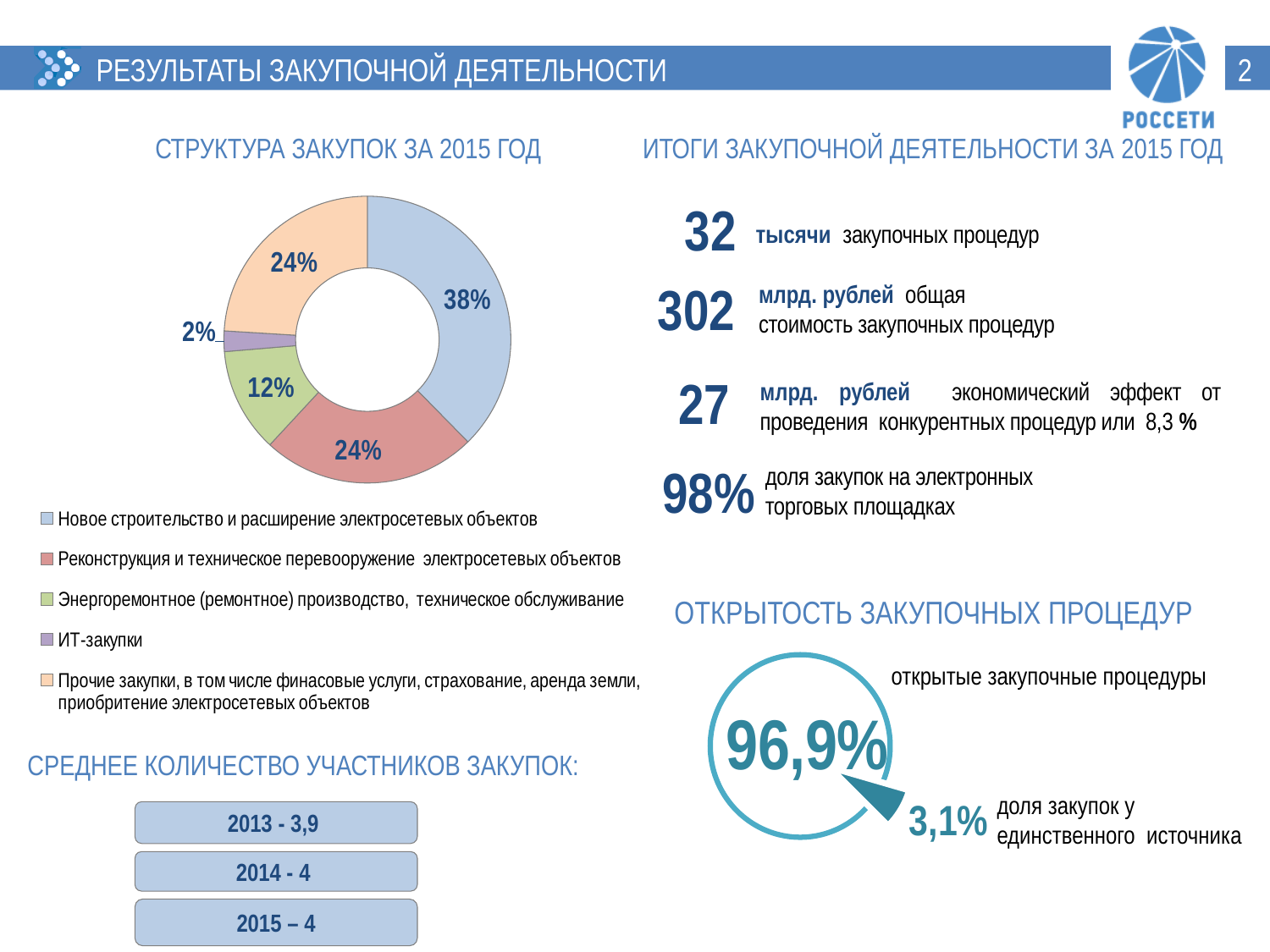
In the chart 'СТРУКТУРА ЗАКУПОК ЗА 2015 ГОД', what share is shown for 'Энергоремонтное (ремонтное) производство, техническое обслуживание'? 12% In the chart 'СТРУКТУРА ЗАКУПОК ЗА 2015 ГОД', which is larger: the share for 'Реконструкция и техническое перевооружение электросетевых объектов' or the share for 'ИТ-закупки'? Реконструкция и техническое перевооружение электросетевых объектов In the chart 'СТРУКТУРА ЗАКУПОК ЗА 2015 ГОД', what share is shown for 'Реконструкция и техническое перевооружение электросетевых объектов'? 24% In the chart 'СТРУКТУРА ЗАКУПОК ЗА 2015 ГОД', which category has the largest share? Новое строительство и расширение электросетевых объектов In the chart 'ОТКРЫТОСТЬ ЗАКУПОЧНЫХ ПРОЦЕДУР', what share is shown for 'доля закупок у единственного источника'? 3,1% In the chart 'СТРУКТУРА ЗАКУПОК ЗА 2015 ГОД', what colour is the slice for 'Прочие закупки, в том числе финасовые услуги, страхование, аренда земли, приобритение электросетевых объектов'? Peach (light orange) What kind of chart is 'СТРУКТУРА ЗАКУПОК ЗА 2015 ГОД'? Donut (pie) chart In the chart 'СТРУКТУРА ЗАКУПОК ЗА 2015 ГОД', what share is shown for 'Новое строительство и расширение электросетевых объектов'? 38% In the chart 'СТРУКТУРА ЗАКУПОК ЗА 2015 ГОД', what is the difference in percentage points between 'Новое строительство и расширение электросетевых объектов' and 'Энергоремонтное (ремонтное) производство, техническое обслуживание'? 26 percentage points How many categories does the legend of the chart 'СТРУКТУРА ЗАКУПОК ЗА 2015 ГОД' list? 5 In the chart 'СТРУКТУРА ЗАКУПОК ЗА 2015 ГОД', what share is shown for 'ИТ-закупки'? 2% In the chart 'СТРУКТУРА ЗАКУПОК ЗА 2015 ГОД', which category has the smallest share? ИТ-закупки